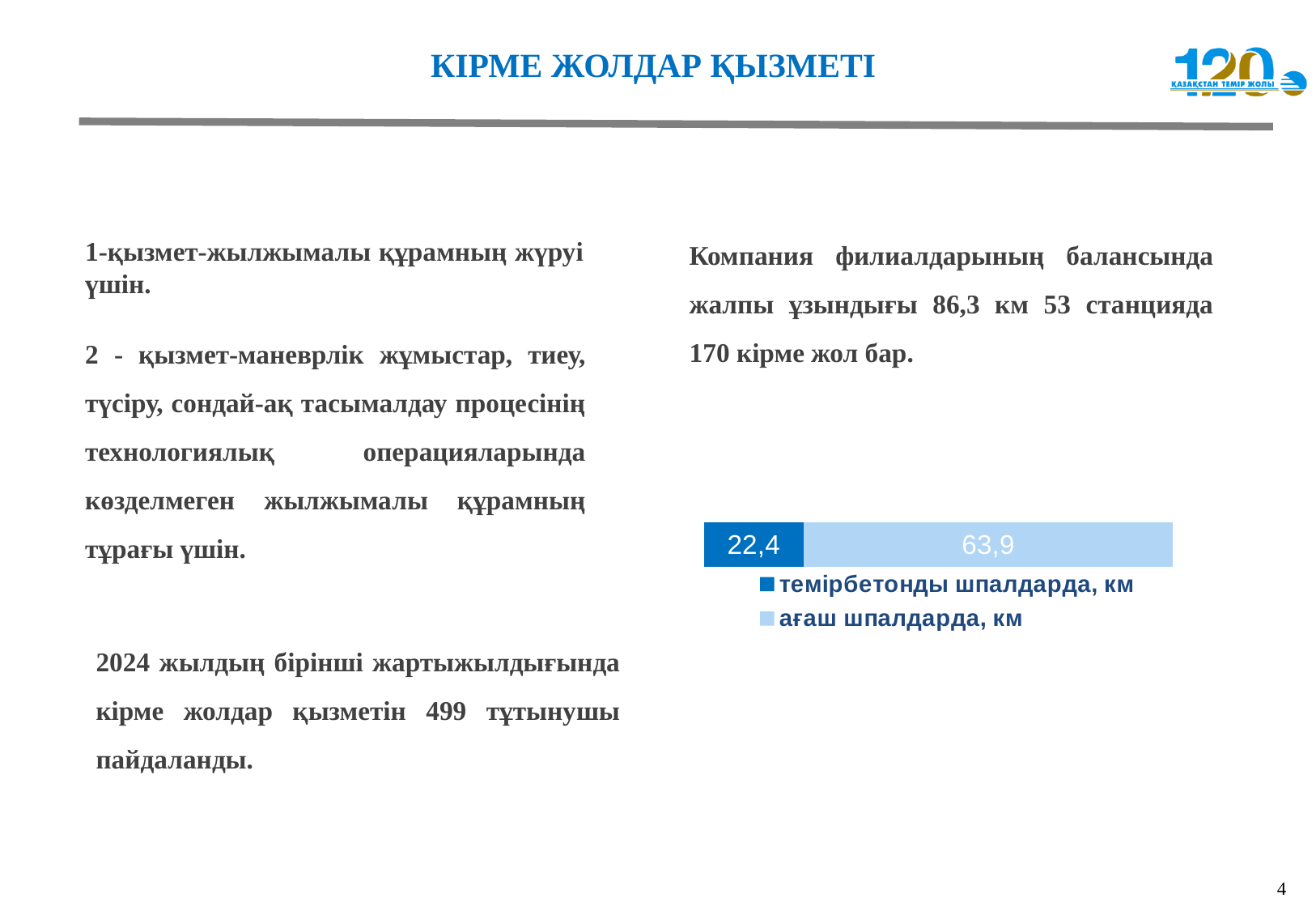
What is the difference between the value for ағаш шпалдарда, км and темірбетонды шпалдарда, км? 41,5 Which series has the largest value in the chart? ағаш шпалдарда, км Which legend entry is shown in light blue in the chart? ағаш шпалдарда, км What is the value for темірбетонды шпалдарда, км in the chart? 22,4 What kind of chart is shown on the slide? Stacked bar chart Which legend entry is shown in dark blue in the chart? темірбетонды шпалдарда, км What is the value for ағаш шпалдарда, км in the chart? 63,9 Which series has the larger value in the chart, темірбетонды шпалдарда or ағаш шпалдарда? ағаш шпалдарда, км Which series has the smallest value in the chart? темірбетонды шпалдарда, км What is the total of the stacked bar in the chart? 86,3 How many series does the legend of the chart list? 2